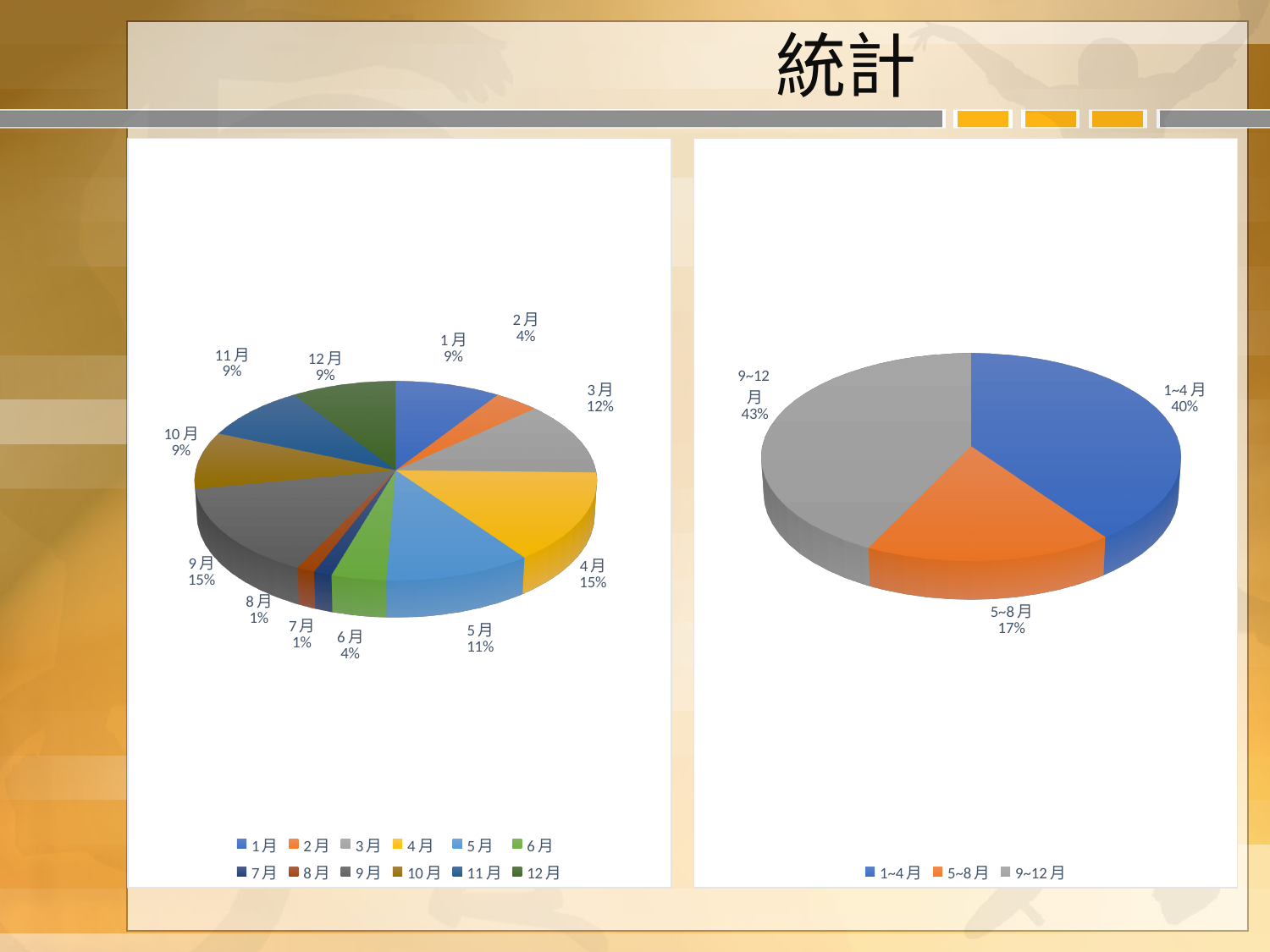
On the left pie chart, which is larger, the share for 4月 or the share for 2月? 4月 On the right pie chart, what is the difference between the shares for 9~12月 and 5~8月? 26% On the left pie chart, what is the difference between the shares for 9月 and 10月? 6% On the left pie chart, what is the share for 5月? 11% On the left pie chart, what is the share for 7月? 1% On the right pie chart, what is the share for 1~4月? 40% On the left pie chart, what is the share for 3月? 12% What kind of chart is the chart on the right? Pie chart On the right pie chart, which category has the largest share? 9~12月 On the right pie chart, which category has the smallest share? 5~8月 How many entries does the legend of the right pie chart list? 3 How many slices does the left pie chart have? 12